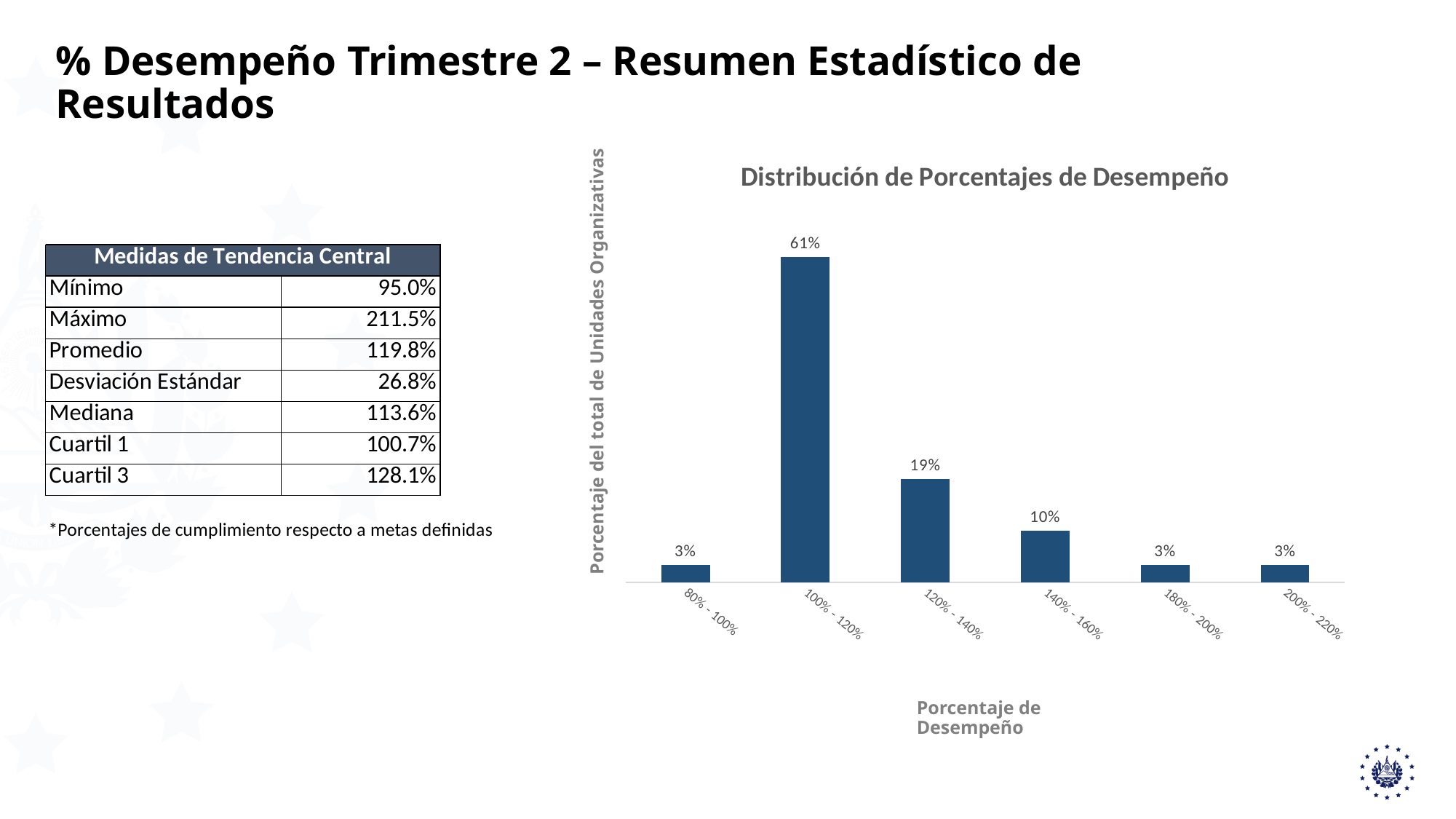
Which category has the highest value? 100% - 120% What is the difference between the values for 120% - 140% and 140% - 160%? 9% What is the title of the chart? Distribución de Porcentajes de Desempeño What is the value for the 120% - 140% category? 19% How many categories are shown on the x axis? 6 What is the label of the x axis? Porcentaje de Desempeño What is the value for the 100% - 120% category? 61% What kind of chart is shown? Bar chart Which is larger, the value for 140% - 160% or the value for 180% - 200%? 140% - 160% What is the difference between the values for 100% - 120% and 120% - 140%? 42% What is the value for the 140% - 160% category? 10% What is the value for the 80% - 100% category? 3%